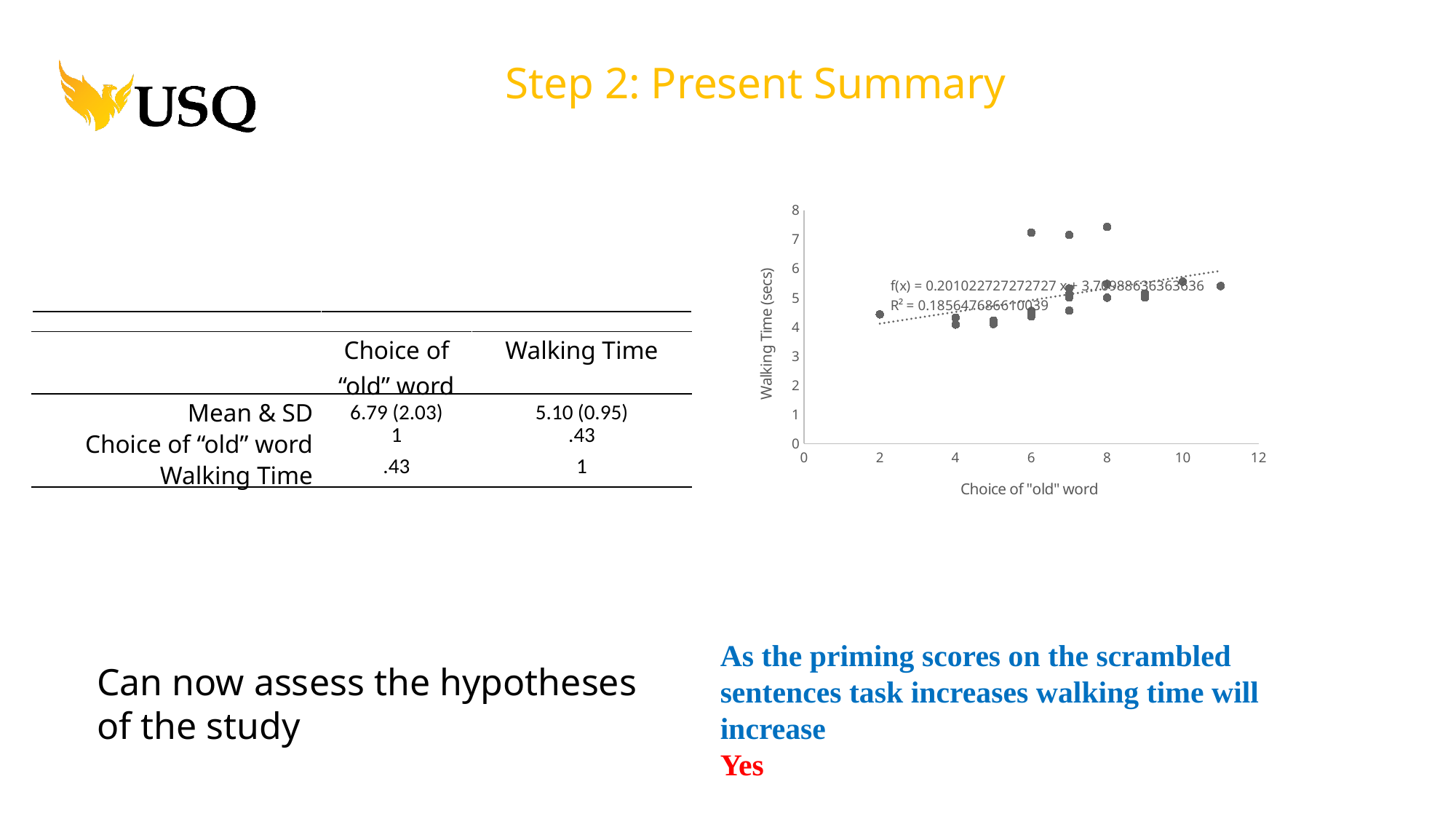
What is the title of the x axis of the chart? Choice of "old" word What is the title of the y axis of the chart? Walking Time (secs) What is the maximum value shown on the y axis of the chart? 8 Is the walking time for the point at a choice of "old" word score of 2 greater or less than 4? greater Is the walking time for the point at a choice of "old" word score of 10 greater or less than 6? less Is the walking time for the point at a choice of "old" word score of 11 greater or less than 5? greater What kind of chart is shown on the slide? scatter chart What is the slope of the fitted trendline shown in the chart's equation? 0.201022727272727 What is the maximum value shown on the x axis of the chart? 12 Do the walking time values generally rise or fall as the choice of "old" word score increases along the x axis? rise